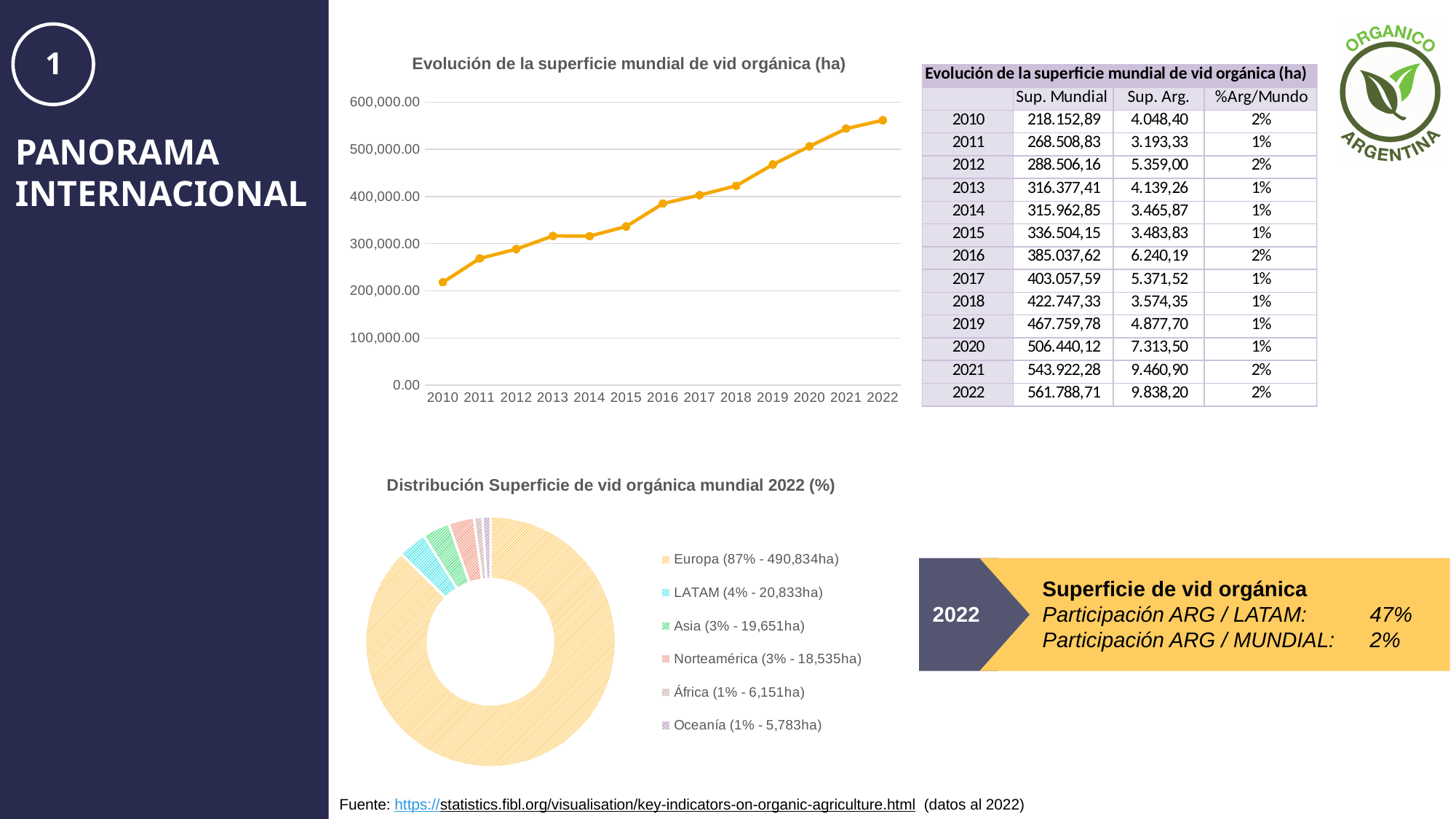
How many years are plotted on the x axis of the top line chart 'Evolución de la superficie mundial de vid orgánica (ha)'? 13 In the top line chart 'Evolución de la superficie mundial de vid orgánica (ha)', do the values generally rise or fall from 2010 to 2022? rise In the top line chart 'Evolución de la superficie mundial de vid orgánica (ha)', is the value for 2010 greater or less than 300,000.00? less In the top line chart 'Evolución de la superficie mundial de vid orgánica (ha)', is the value for 2019 greater or less than 400,000.00? greater In the bottom chart 'Distribución Superficie de vid orgánica mundial 2022 (%)', what is the difference in hectares between Asia and Norteamérica? 1,116ha What kind of chart is the top chart titled 'Evolución de la superficie mundial de vid orgánica (ha)'? line chart In the bottom chart 'Distribución Superficie de vid orgánica mundial 2022 (%)', how many hectares does the legend give for LATAM? 20,833ha In the top line chart 'Evolución de la superficie mundial de vid orgánica (ha)', which year has the highest value? 2022 How many regions are listed in the legend of the bottom chart 'Distribución Superficie de vid orgánica mundial 2022 (%)'? 6 What kind of chart is the bottom chart titled 'Distribución Superficie de vid orgánica mundial 2022 (%)'? doughnut chart In the top line chart 'Evolución de la superficie mundial de vid orgánica (ha)', is the value for 2022 greater or less than 500,000.00? greater In the bottom chart 'Distribución Superficie de vid orgánica mundial 2022 (%)', what share does Europa have? 87%